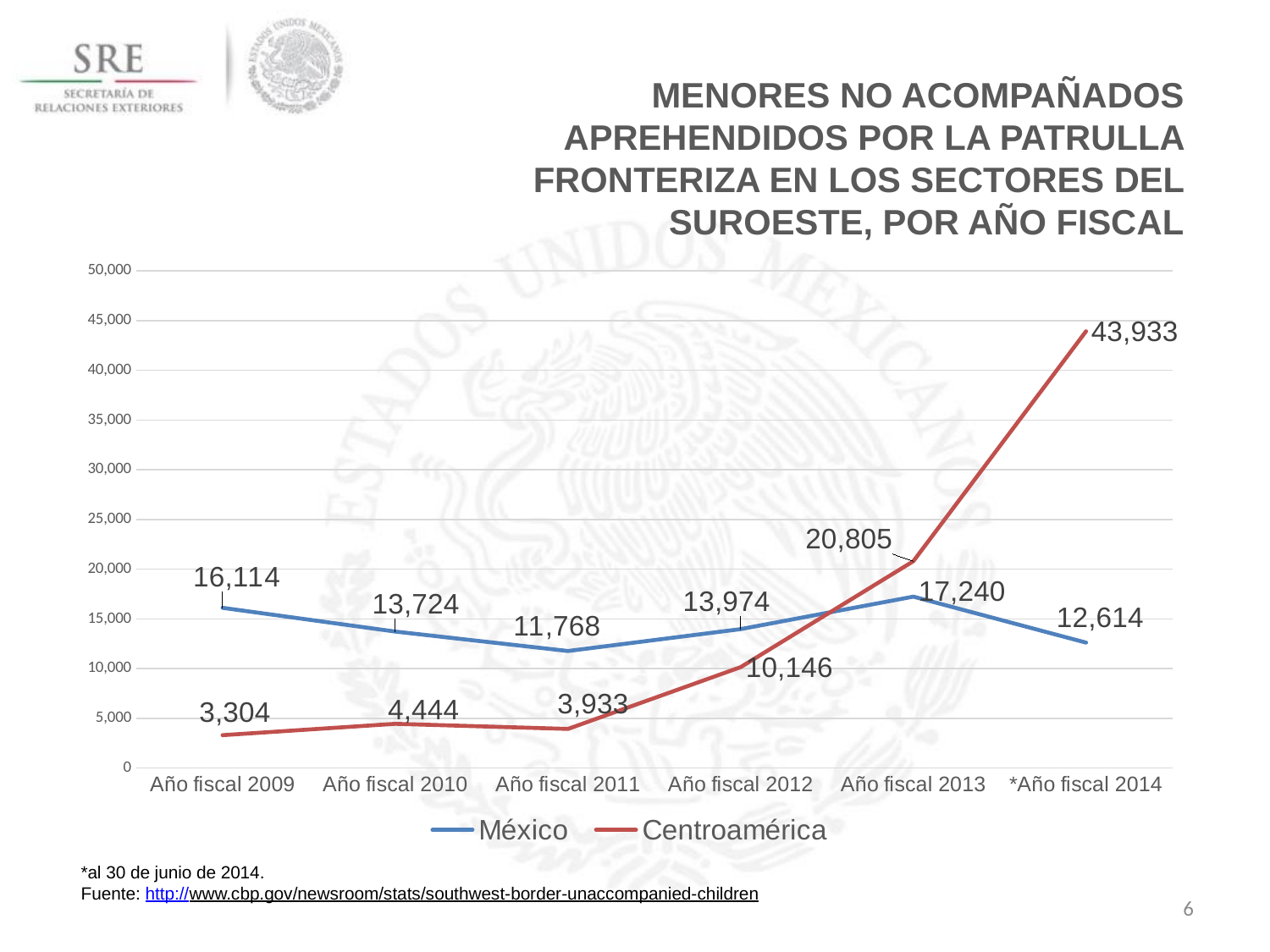
In which fiscal year is the value for México highest? Año fiscal 2013 Does the Centroamérica series rise or fall from Año fiscal 2012 to *Año fiscal 2014? rise What is the value for Centroamérica in *Año fiscal 2014? 43,933 What type of chart is shown on the slide? line chart What is the difference between the Centroamérica and México values in *Año fiscal 2014? 31,319 How many fiscal years are plotted on the x axis? 6 How many series does the legend list? 2 What colour is the line for Centroamérica? red Which series has the larger value in Año fiscal 2011, México or Centroamérica? México In which fiscal year is the value for Centroamérica lowest? Año fiscal 2009 What is the value for Centroamérica in Año fiscal 2012? 10,146 What is the value for México in Año fiscal 2009? 16,114